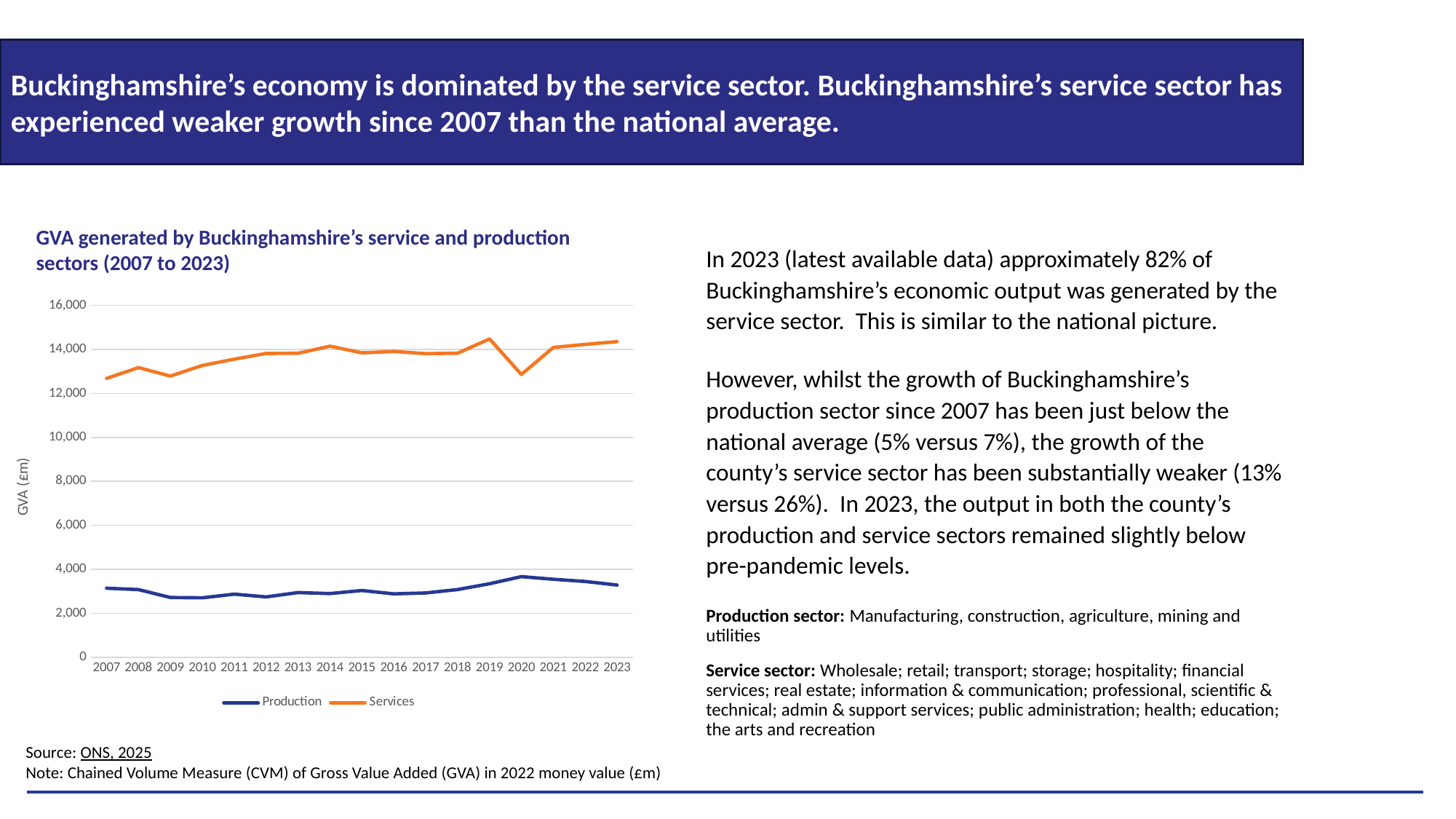
Is the value for Services in 2019 greater or less than 14,000? greater In which year does the Production line reach its highest point? 2020 How many series does the legend list? 2 Is the value for Production in 2009 greater or less than 2,000? greater What kind of chart is shown on the slide? Line chart In which year does the Services line reach its lowest point? 2007 How many years are shown on the x axis? 17 Which series has the higher value in 2023, Production or Services? Services What are the two series named in the legend? Production and Services Is the value for Production in 2020 greater or less than 4,000? less What is the label on the vertical axis? GVA (£m)